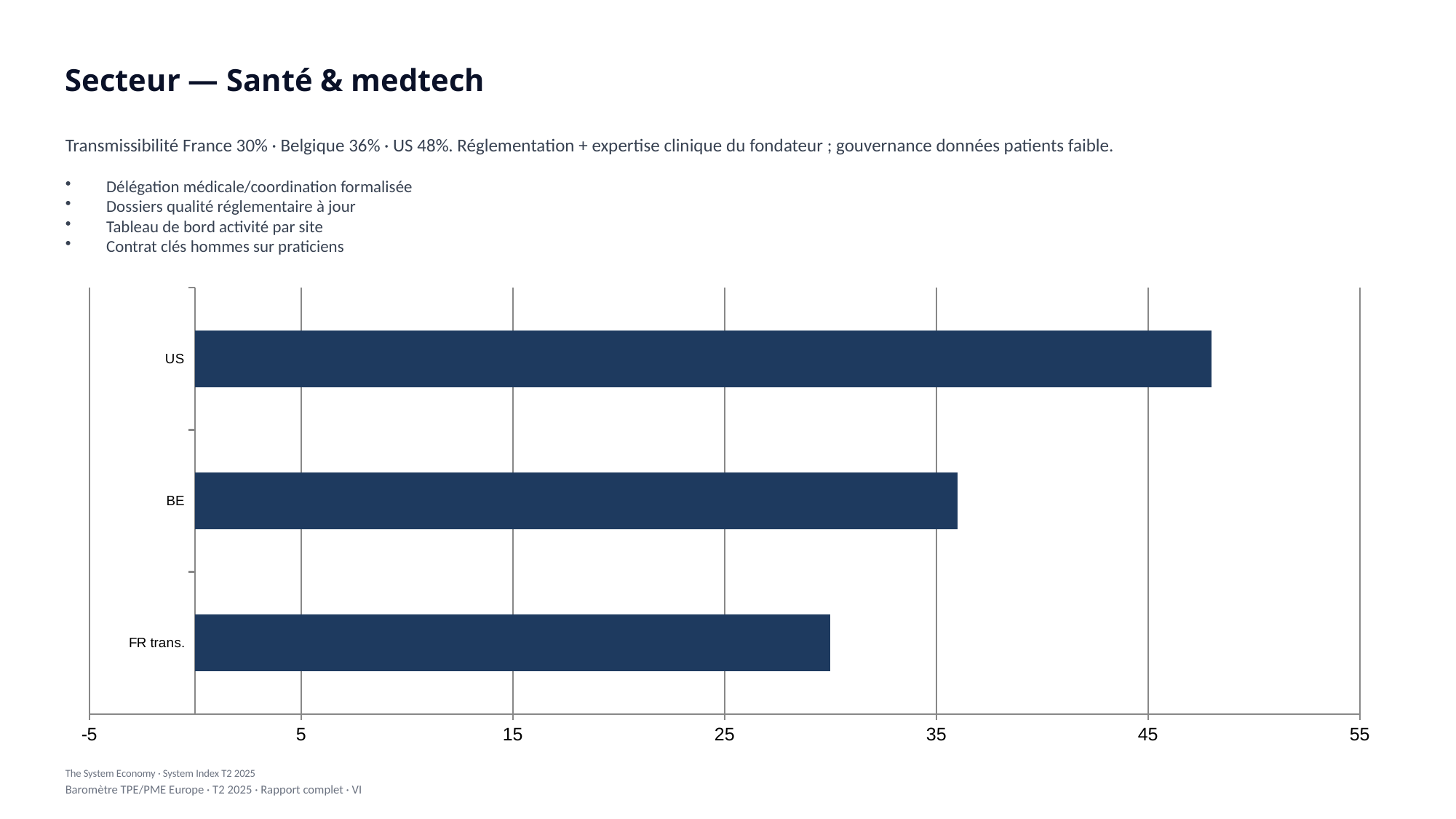
Which is larger, the value for BE or the value for FR trans.? BE Is the value for BE greater or less than 35? greater Which category has the lowest value in the chart? FR trans. What is the highest tick value shown on the horizontal axis? 55 Is the value for FR trans. greater or less than 35? less What kind of chart is shown on the slide? bar chart Which category has the highest value in the chart? US Is the value for US greater or less than 55? less How many categories are plotted in the chart? 3 Which is larger, the value for US or the value for BE? US